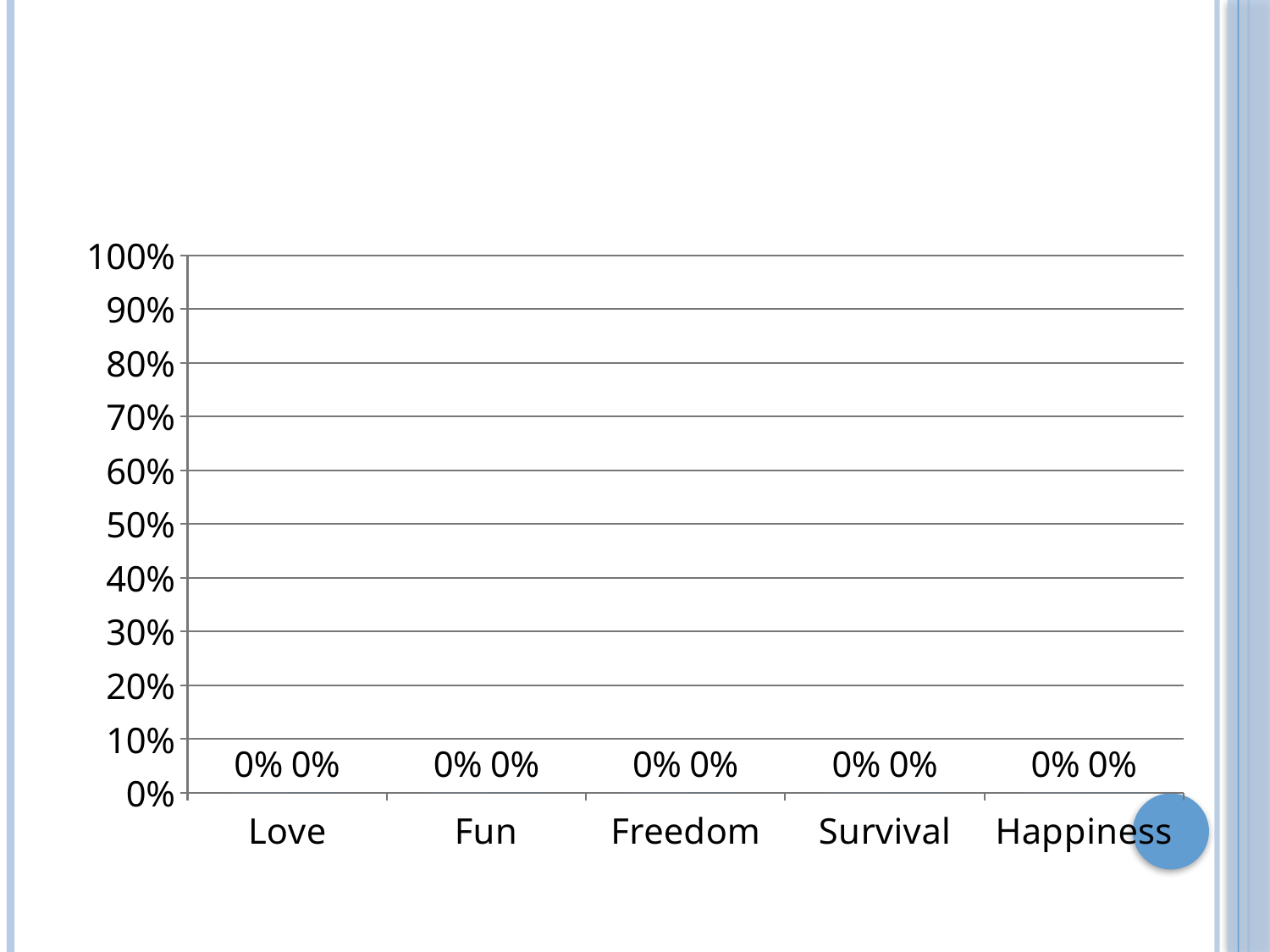
How many categories are shown on the x axis of the chart? 5 Which category is listed third on the x axis? Freedom What value is labelled for Love in the chart? 0% Do the labelled values rise, fall, or stay flat from Love to Happiness? stay flat What is the total of the two labelled values for Survival? 0% What is the highest value shown on the y axis? 100% What value is labelled for Survival in the chart? 0% Is the value for Fun greater or less than 50%? less Is the value for Freedom greater or less than 20%? less What value is labelled for Happiness in the chart? 0% What is the difference between the labelled values for Fun and Freedom? 0% How many data labels are printed above each category? 2